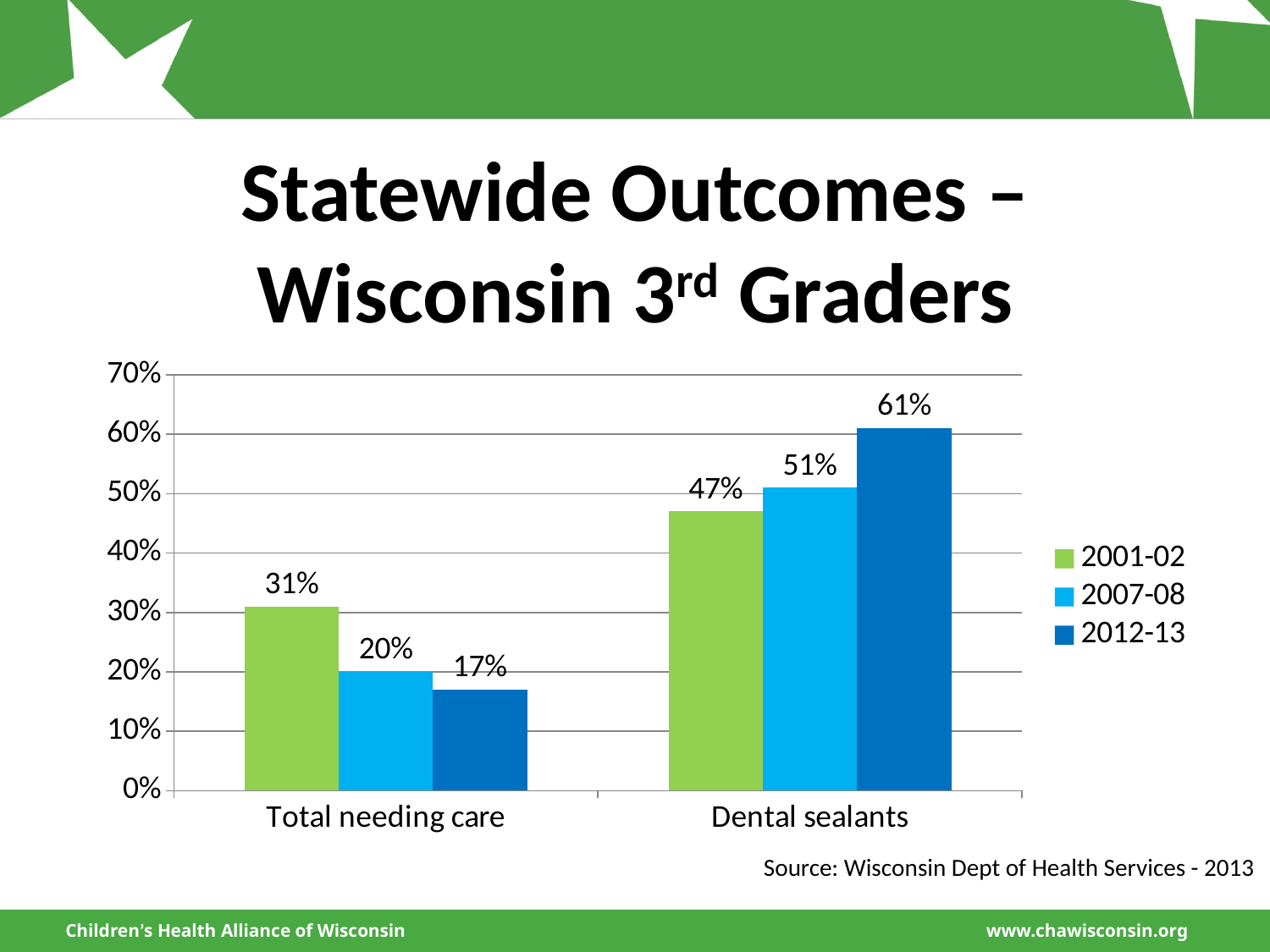
Does the value for Dental sealants rise or fall from 2001-02 to 2012-13? Rise Which series has the lowest value for Total needing care? 2012-13 What is the value for Total needing care in 2001-02? 31% What is the value for Dental sealants in 2012-13? 61% Which is larger: the 2007-08 value for Dental sealants or the 2007-08 value for Total needing care? Dental sealants What is the value for Total needing care in 2007-08? 20% What kind of chart is shown on the slide? Bar chart How many categories are shown on the x axis? 2 What is the difference between the 2001-02 and 2012-13 values for Total needing care? 14% Which series has the highest value for Dental sealants? 2012-13 What is the difference between the 2012-13 and 2001-02 values for Dental sealants? 14% How many series does the legend list? 3